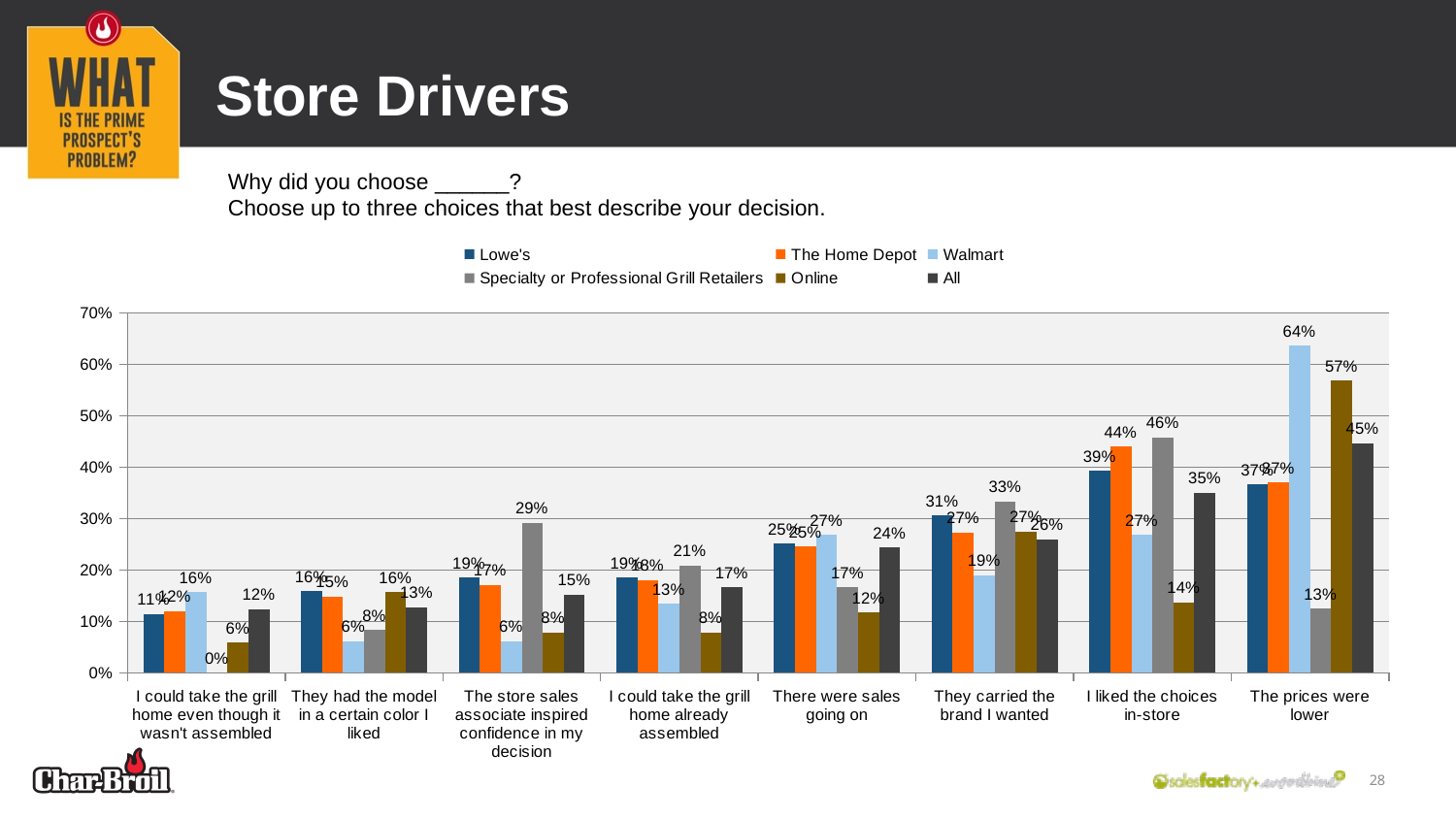
How many series does the legend list? 6 What is the difference between the Walmart and Online values for "The prices were lower"? 7 percentage points How many reason categories are shown along the x axis? 8 What is the All value for "I liked the choices in-store"? 35% What kind of chart is shown on the slide? Bar chart Which series has the lowest value for "I could take the grill home even though it wasn't assembled"? Specialty or Professional Grill Retailers What is the Walmart value for "The prices were lower"? 64% Which series is shown in orange in the legend? The Home Depot For "I liked the choices in-store", which is larger: the Lowe's value or the Walmart value? Lowe's Which series has the highest value for "The prices were lower"? Walmart What is the Specialty or Professional Grill Retailers value for "The store sales associate inspired confidence in my decision"? 29% What is the Online value for "The prices were lower"? 57%